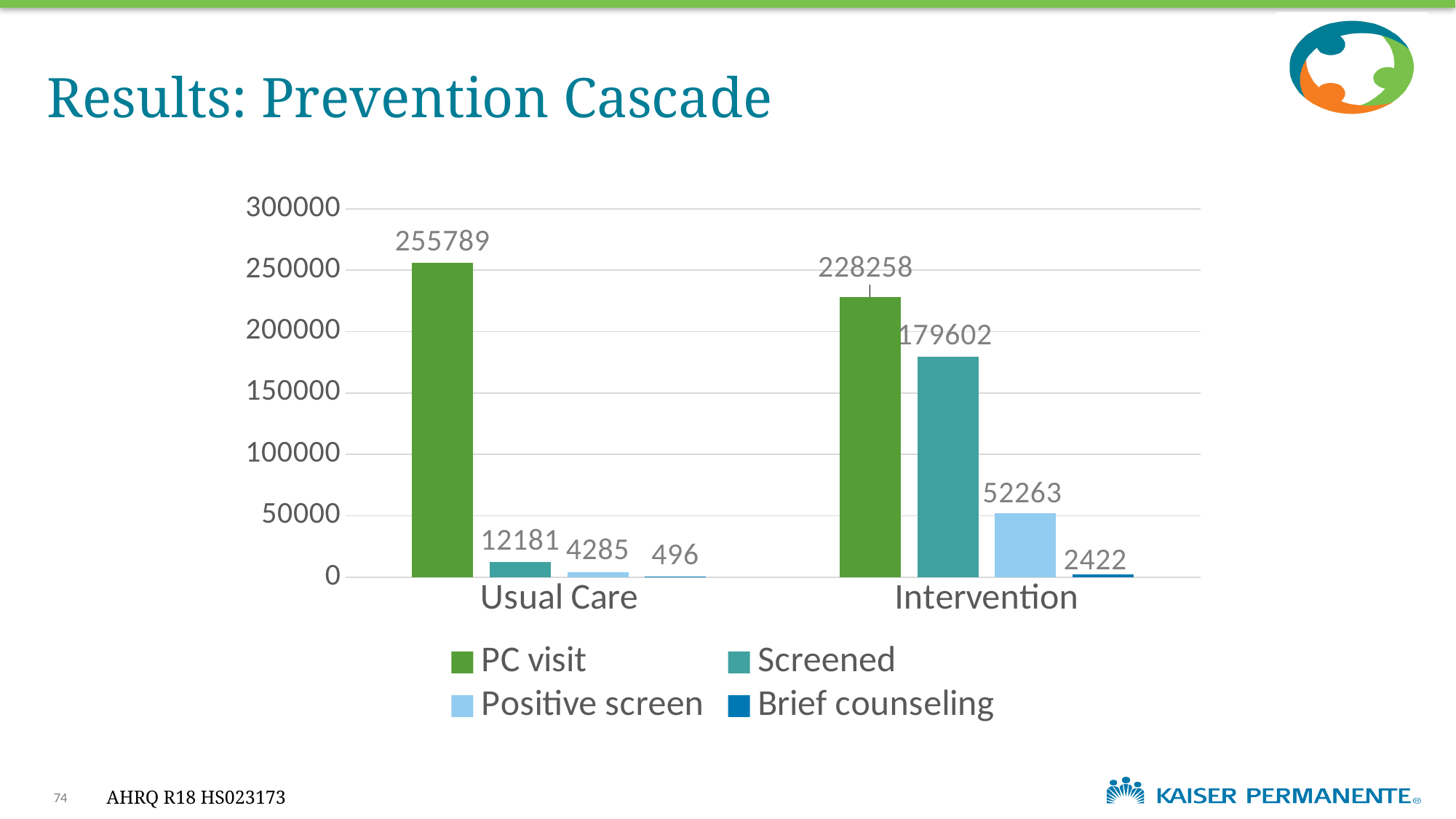
What is the value for Screened in the Intervention group? 179602 Is the value for Screened in the Intervention group greater or less than 150000? greater How many series does the legend list? 4 What is the value for PC visit in the Usual Care group? 255789 Which series has the highest value in the Intervention group? PC visit Which series has the lowest value in the Usual Care group? Brief counseling Which is larger: Screened in Usual Care or Screened in Intervention? Screened in Intervention What is the value for Brief counseling in the Usual Care group? 496 What is the difference between the PC visit values for Usual Care and Intervention? 27531 What kind of chart is shown on the slide? Bar chart What is the value for Positive screen in the Intervention group? 52263 How many categories are shown on the x axis? 2